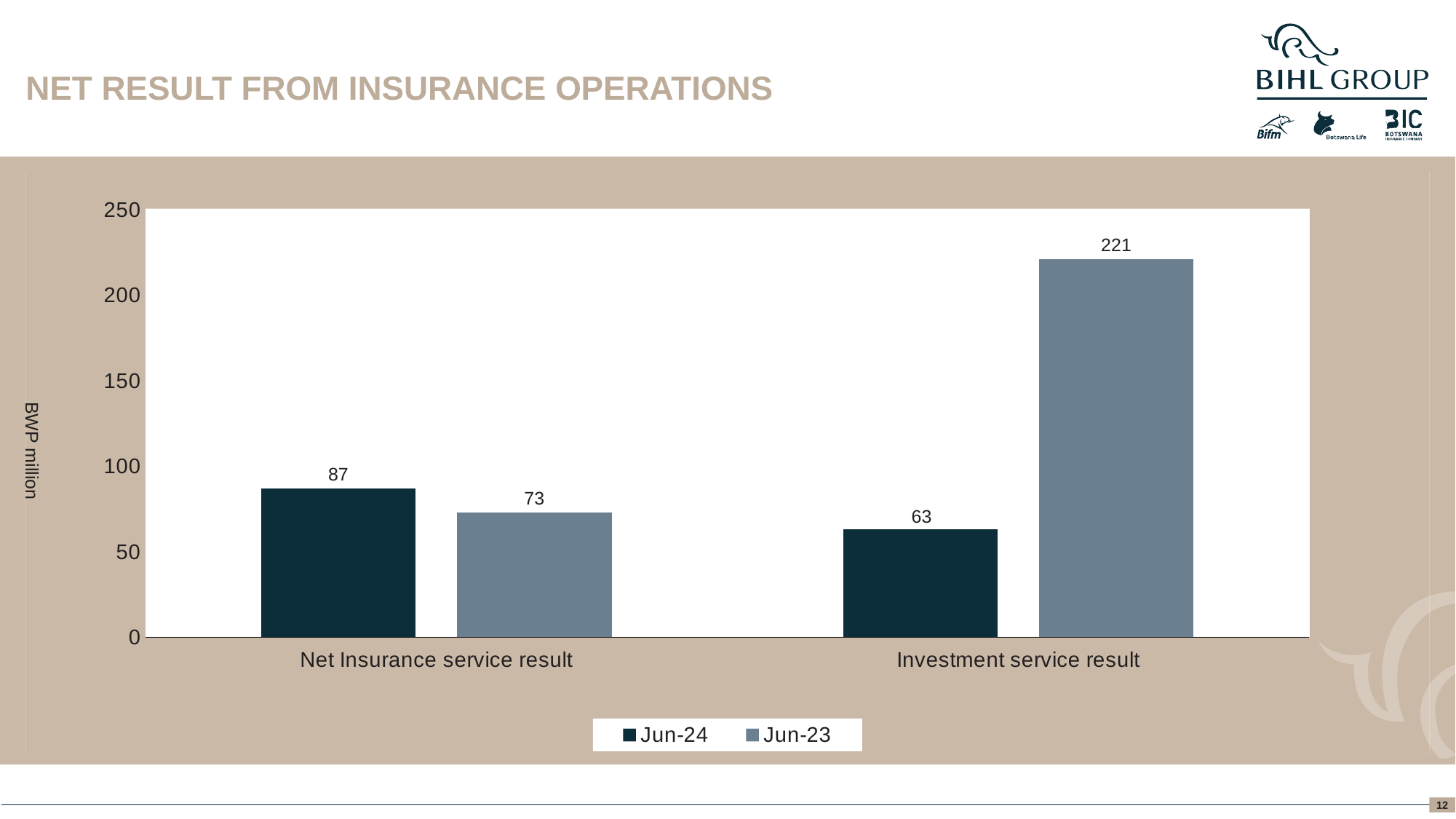
What is the Jun-23 value for Investment service result? 221 What kind of chart is shown on the slide? Bar chart What is the Jun-24 value for Net Insurance service result? 87 Which bar has the lowest value on the chart? Investment service result, Jun-24 What unit is shown on the vertical axis label? BWP million What is the difference between the Jun-24 and Jun-23 values for Net Insurance service result? 14 Which bar has the highest value on the chart? Investment service result, Jun-23 For Net Insurance service result, which is larger: Jun-24 or Jun-23? Jun-24 What is the Jun-24 value for Investment service result? 63 What is the Jun-23 value for Net Insurance service result? 73 How many series does the legend list? 2 What is the difference between the Jun-23 and Jun-24 values for Investment service result? 158